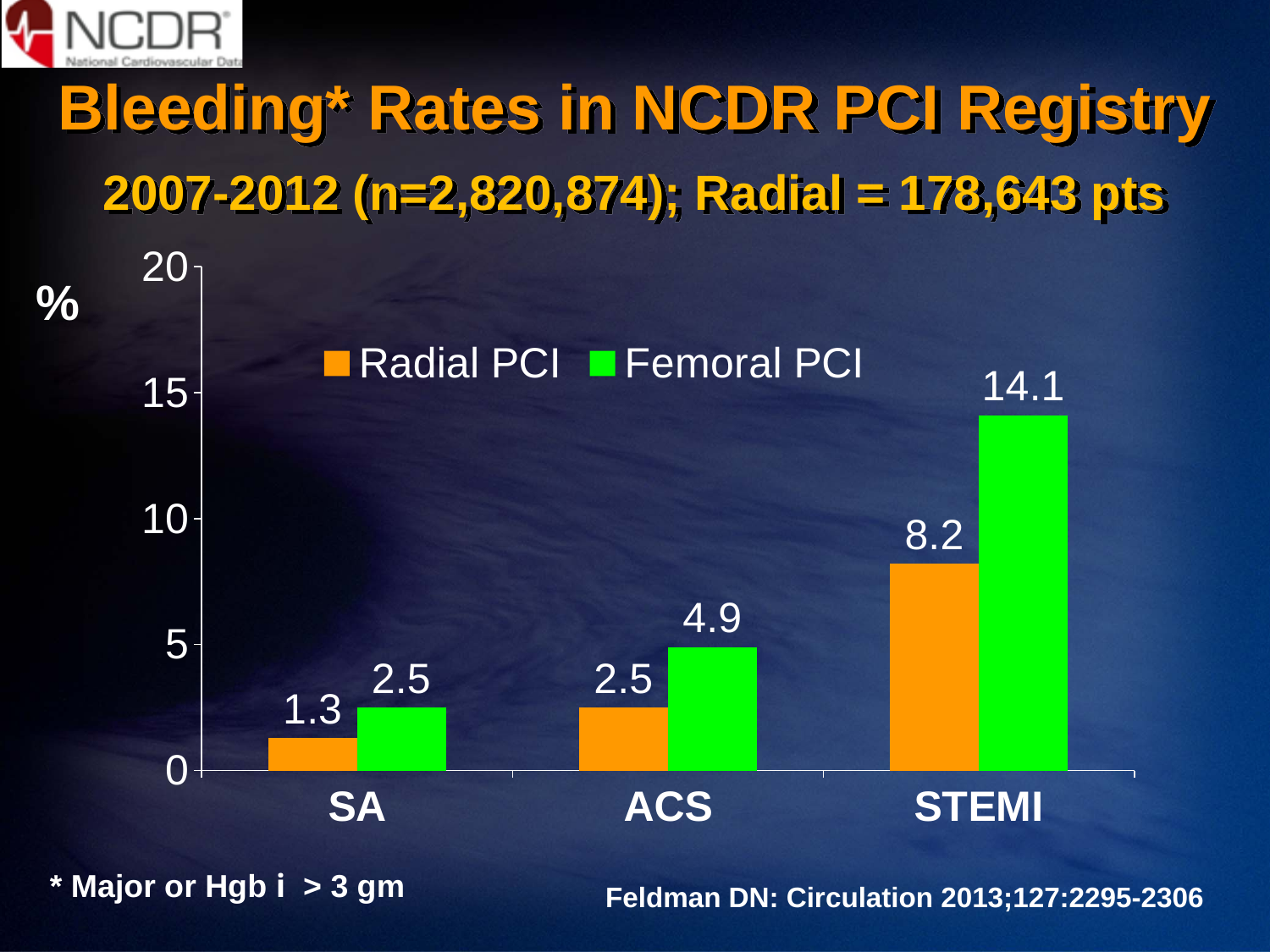
How many series does the legend list? 2 Which category has the lowest Radial PCI bleeding rate? SA What is the difference between the Femoral PCI and Radial PCI rates for ACS? 2.4 How many categories are shown on the x axis? 3 What kind of chart is shown on the slide? Bar chart Which category has the highest Femoral PCI bleeding rate? STEMI Which is larger for SA: the Radial PCI rate or the Femoral PCI rate? Femoral PCI What is the Femoral PCI bleeding rate for ACS? 4.9 What is the difference between the Femoral PCI and Radial PCI rates for STEMI? 5.9 Which colour represents Femoral PCI in the chart? Green What is the Radial PCI value for SA? 1.3 What is the Radial PCI bleeding rate for STEMI? 8.2